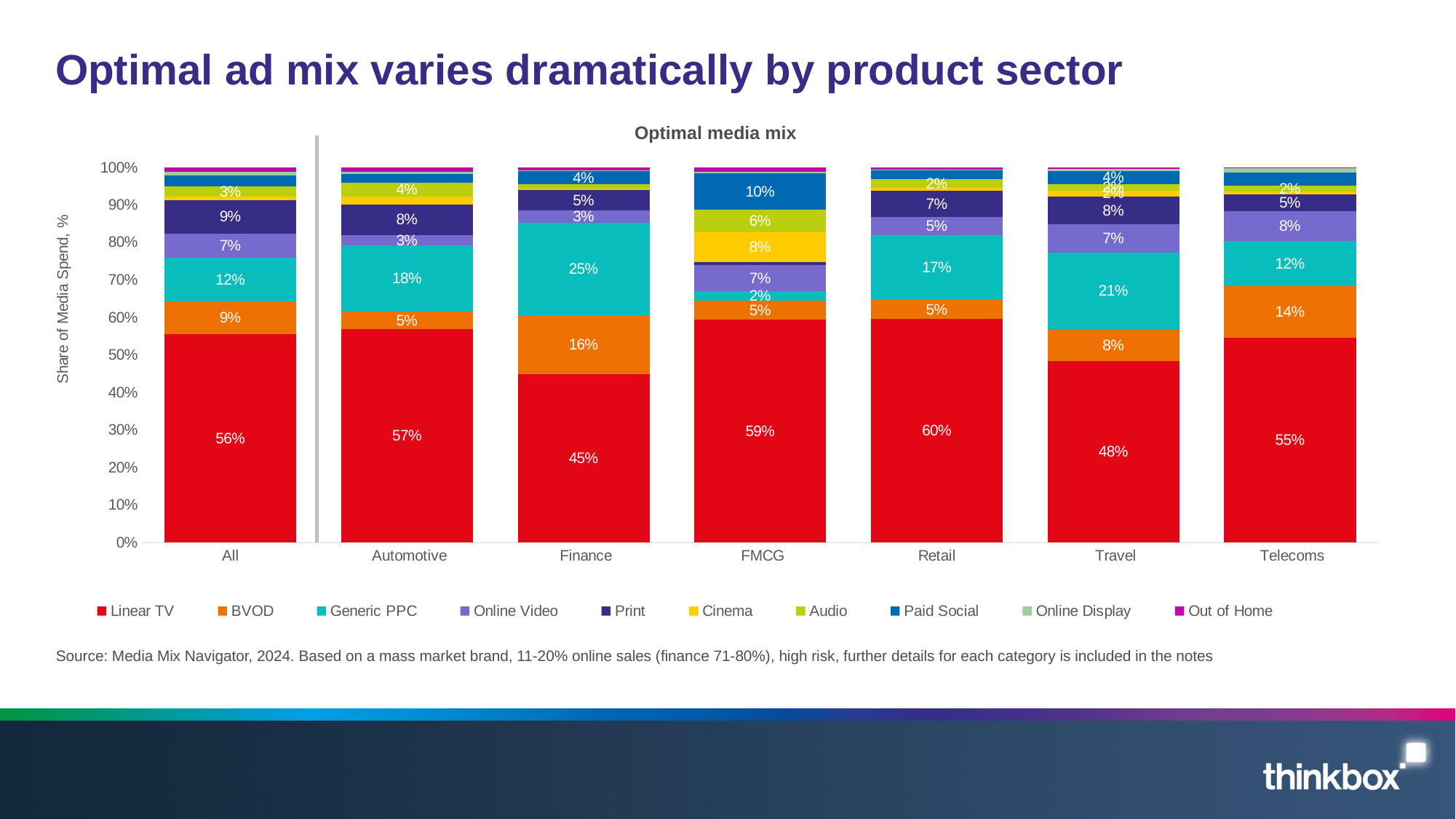
Which sector has the lowest Linear TV share? Finance Which sector has the highest Linear TV share? Retail How many percentage points higher is the Generic PPC share for Finance than for All? 13 percentage points What is the Paid Social share for FMCG? 10% What is the Generic PPC share for the Travel sector? 21% How many series does the legend list? 10 Which has a larger BVOD share, Finance or Automotive? Finance What is the Linear TV share of media spend for the Finance sector? 45% What kind of chart is shown on the slide? Stacked bar chart How many sectors (categories) are shown on the x axis? 7 What is the BVOD share for Telecoms? 14%